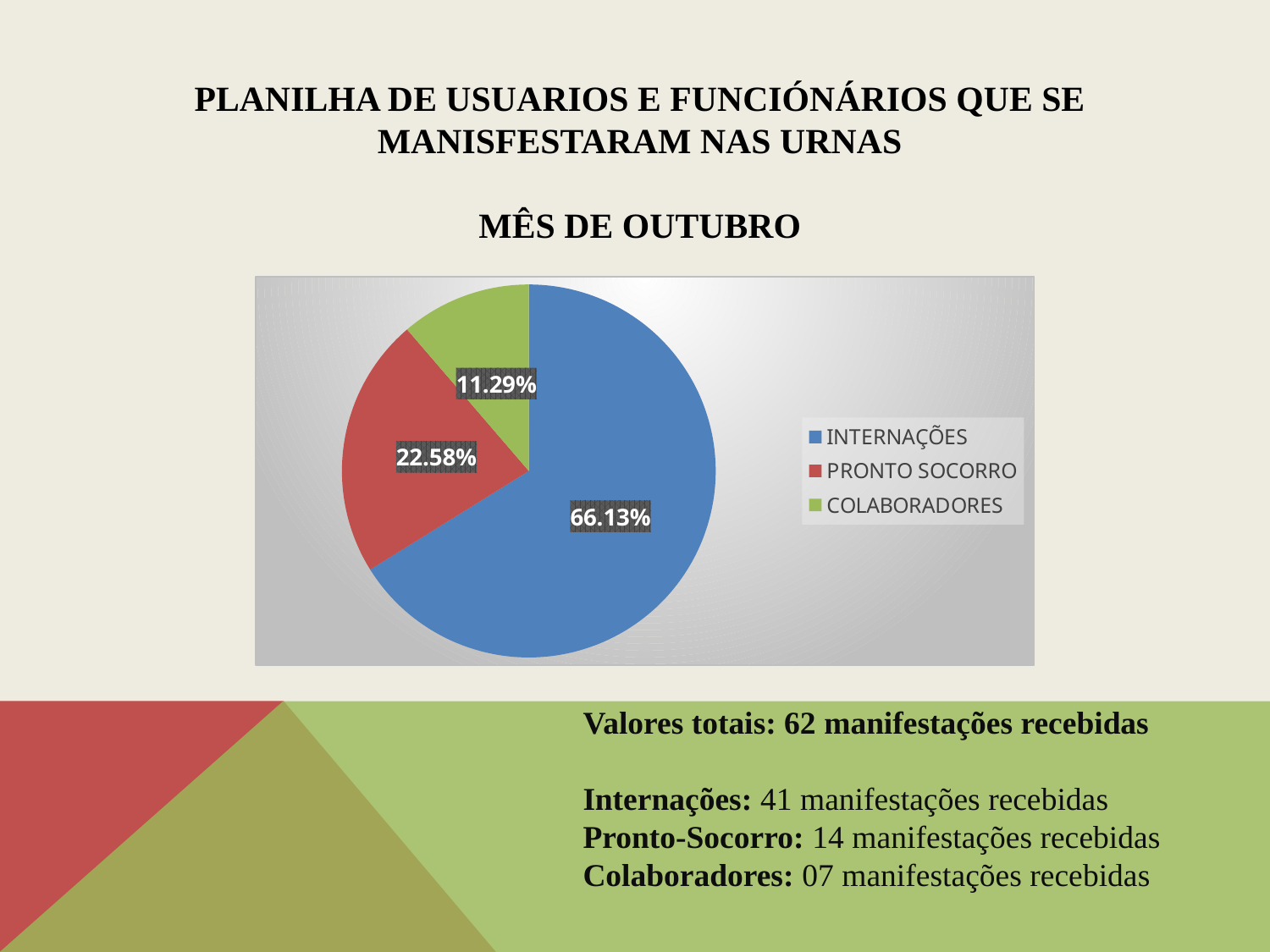
What percentage share does the INTERNAÇÕES slice have? 66.13% Which slice is larger, PRONTO SOCORRO or COLABORADORES? PRONTO SOCORRO Which category has the smallest slice of the pie? COLABORADORES What colour is the COLABORADORES slice? green Which category has the largest slice of the pie? INTERNAÇÕES What colour is the INTERNAÇÕES slice? blue How many slices does the pie chart have? 3 What type of chart is shown on the slide? pie chart How many entries does the legend list? 3 What percentage share does the PRONTO SOCORRO slice have? 22.58% What percentage share does the COLABORADORES slice have? 11.29% What is the difference in percentage points between the INTERNAÇÕES and PRONTO SOCORRO slices? 43.55